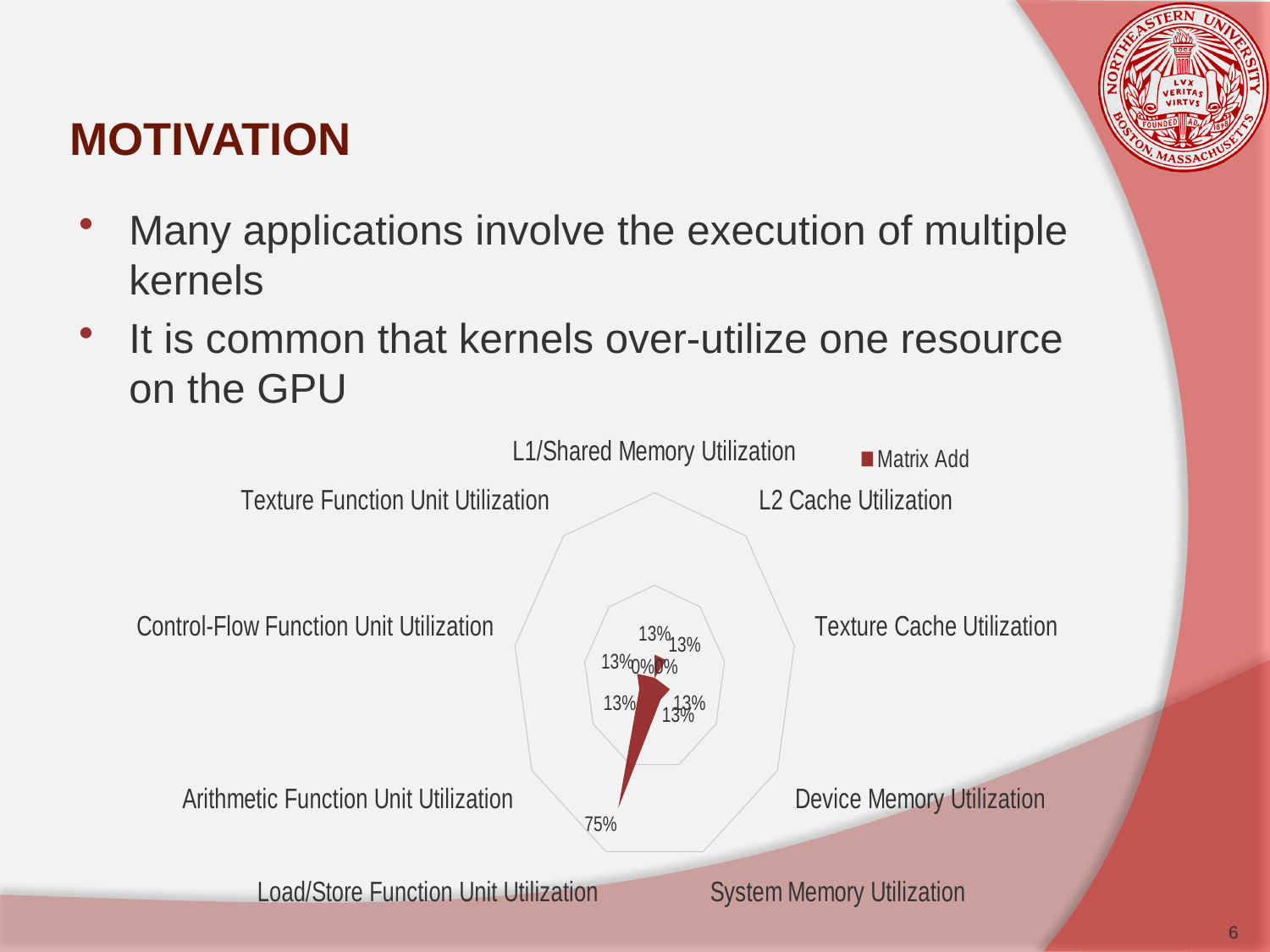
Which is larger, the value for Load/Store Function Unit Utilization or the value for System Memory Utilization? Load/Store Function Unit Utilization What type of chart is shown on the slide? radar chart What is the value for Load/Store Function Unit Utilization? 75% How many categories (axes) does the radar chart have? 9 Which category label appears at the top of the radar chart? L1/Shared Memory Utilization Which is larger, the value for Load/Store Function Unit Utilization or the value for Arithmetic Function Unit Utilization? Load/Store Function Unit Utilization Which category has the highest value in the radar chart? Load/Store Function Unit Utilization What is the name of the series shown in the legend? Matrix Add How many series does the legend list? 1